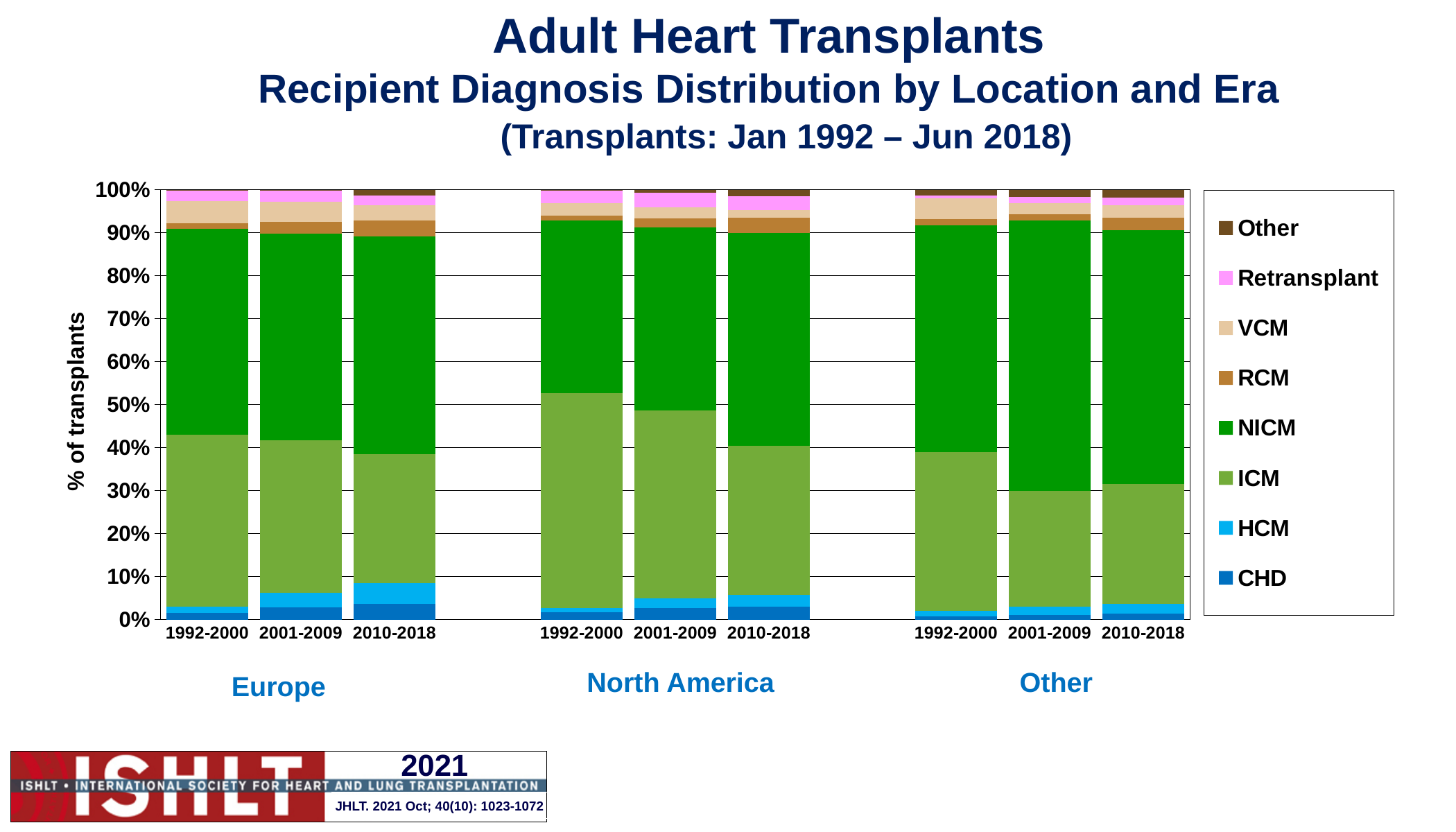
Which bar has the largest ICM share: Europe 1992-2000 or Other 2001-2009? Europe 1992-2000 What is the label on the y axis? % of transplants How many series does the legend list? 8 What kind of chart is shown on the slide? stacked bar chart Across the three eras for Europe, does the ICM share rise or fall? fall How many locations are shown along the x axis? 3 How many stacked bars are plotted in the chart? 9 What is the total height of each stacked bar? 100% In the North America 1992-2000 bar, does the top of the ICM segment sit above or below the 50% line? above In the Other 2001-2009 bar, does the top of the ICM segment sit above or below the 40% line? below In the Europe 2010-2018 bar, does the top of the HCM segment sit above or below the 10% line? below Across the three eras for North America, does the ICM share rise or fall? fall